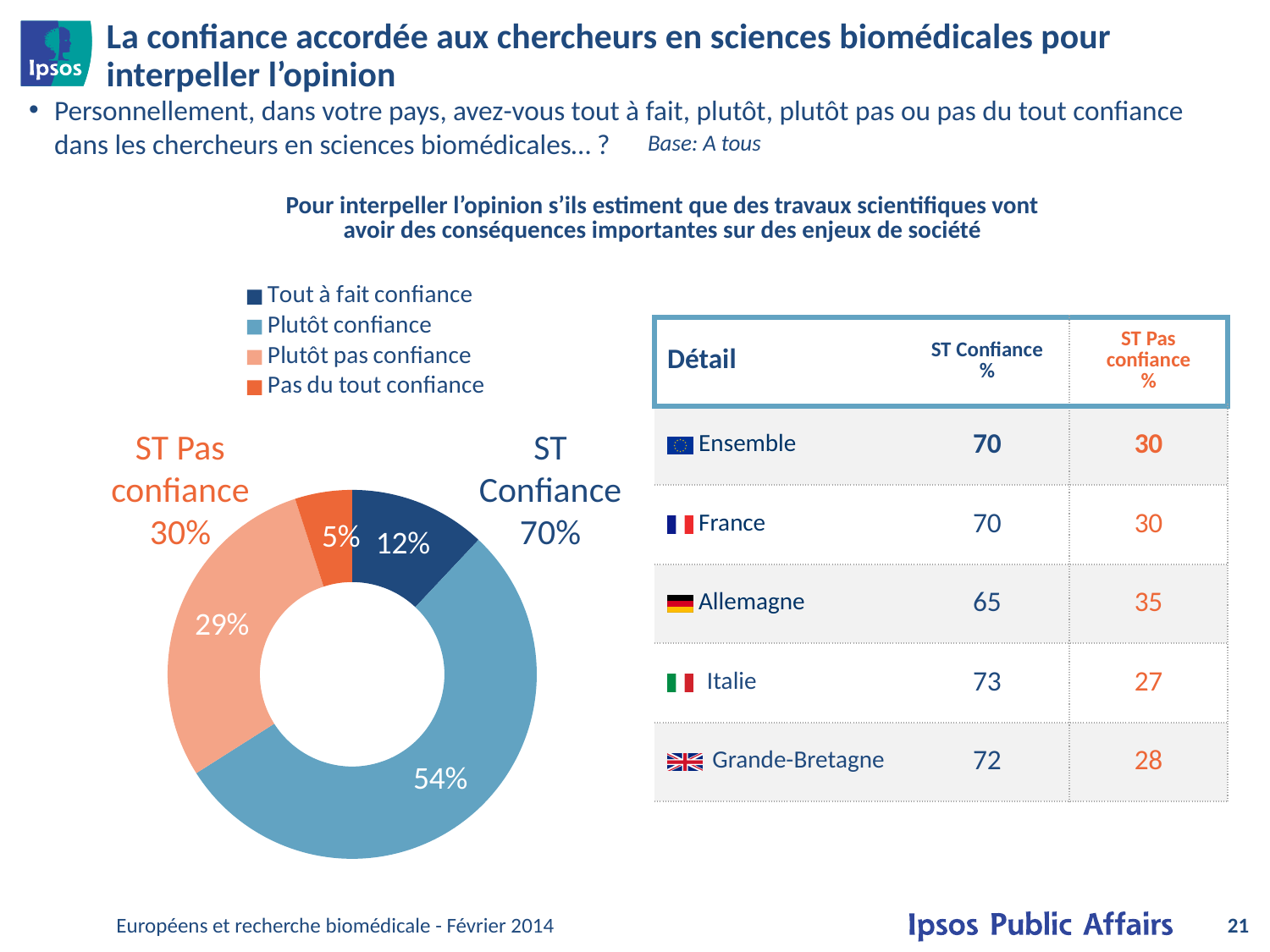
How many categories does the legend of the pie chart list? 4 What type of chart is shown on the slide? Pie chart (donut) Which response category has the largest share of the pie? Plutôt confiance What percentage of respondents answered "Pas du tout confiance"? 5% What is the difference between the "Plutôt confiance" share and the "Plutôt pas confiance" share? 25 percentage points What percentage of respondents answered "Plutôt pas confiance"? 29% What is the combined share labelled "ST Pas confiance" on the chart? 30% Which is larger: the share for "Tout à fait confiance" or the share for "Pas du tout confiance"? Tout à fait confiance Which response category has the smallest share of the pie? Pas du tout confiance What percentage of respondents answered "Tout à fait confiance"? 12% What percentage of respondents answered "Plutôt confiance"? 54% What is the combined share labelled "ST Confiance" on the chart? 70%